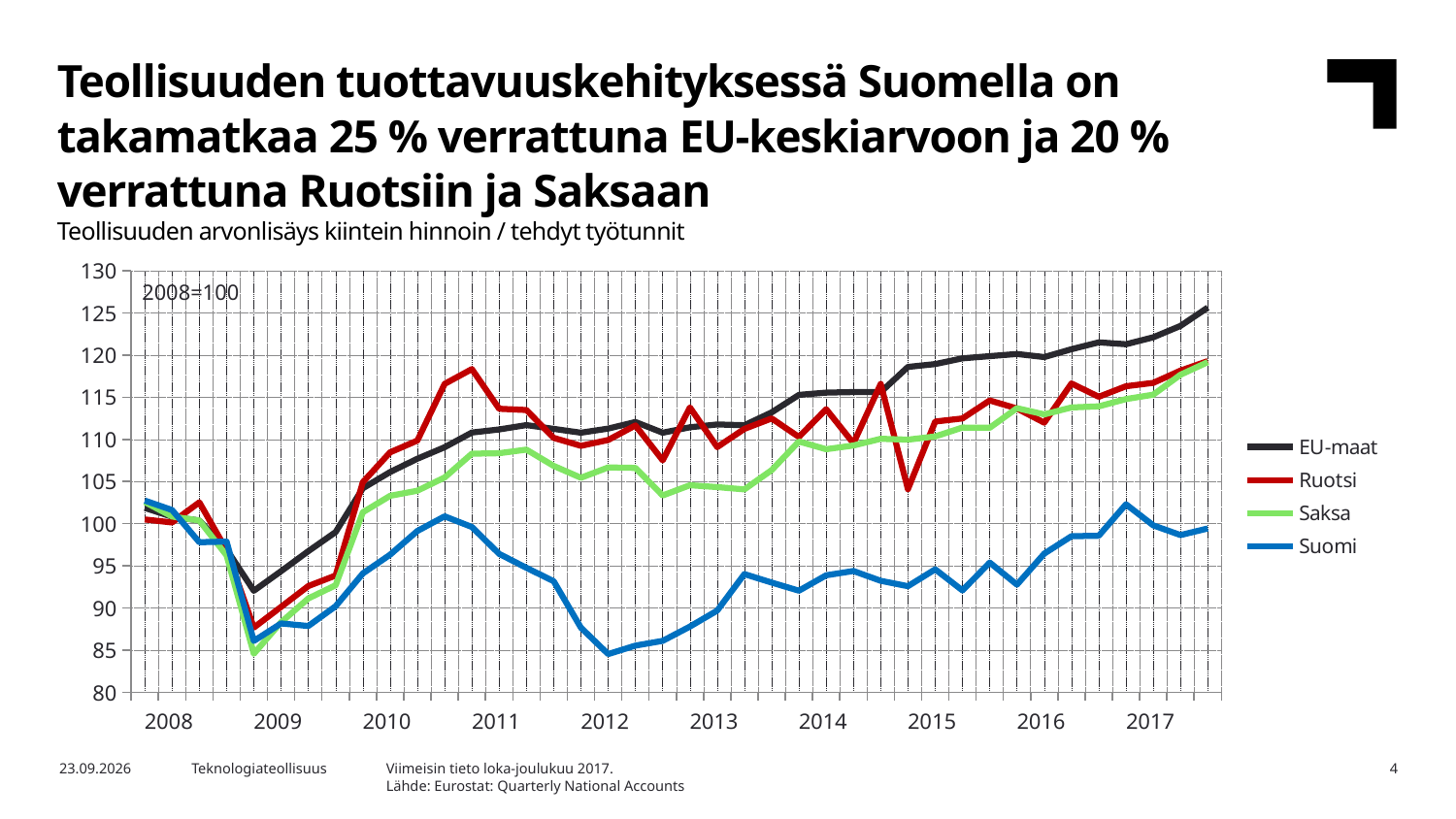
Is the peak value for Ruotsi around late 2010 greater or less than 115? greater Does the EU-maat series rise or fall from 2013 to 2017? rise Is the value for Suomi at the end of 2017 greater or less than 105? less What kind of chart is shown on the slide? line chart Which series has the lowest value at the end of 2017? Suomi What base-year note is printed inside the chart area? 2008=100 Which series are listed in the legend? EU-maat, Ruotsi, Saksa, Suomi At the end of 2017, which is larger: the value for EU-maat or the value for Suomi? EU-maat How many series does the legend list? 4 Which series has the highest value at the end of 2017? EU-maat Is the value for EU-maat at the end of 2017 greater or less than 120? greater